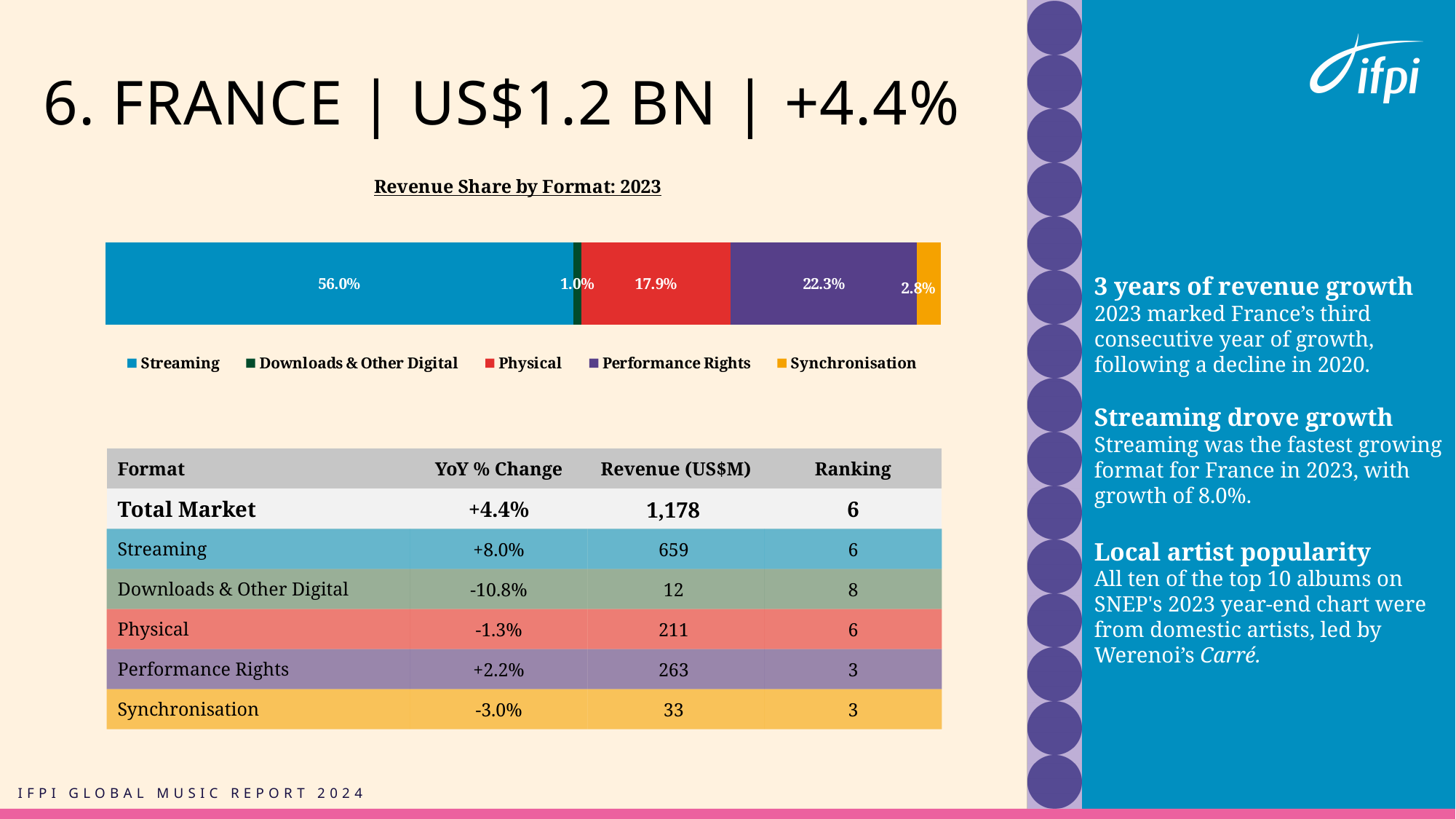
In the Revenue Share by Format chart, what is the difference between the Performance Rights share and the Physical share? 4.4% In the Revenue Share by Format chart, what share does Performance Rights have? 22.3% In the Revenue Share by Format chart, what share does Downloads & Other Digital have? 1.0% In the Revenue Share by Format chart, what share does Streaming have? 56.0% In the Revenue Share by Format chart, what share does Physical have? 17.9% In the Revenue Share by Format chart, what share does Synchronisation have? 2.8% Which format has the largest share in the Revenue Share by Format chart? Streaming In the Revenue Share by Format chart, which is larger: the Physical share or the Performance Rights share? Performance Rights What type of chart is shown under the title "Revenue Share by Format: 2023"? bar chart What is the title of the chart on the slide? Revenue Share by Format: 2023 How many formats does the legend of the Revenue Share by Format chart list? 5 Which format has the smallest share in the Revenue Share by Format chart? Downloads & Other Digital